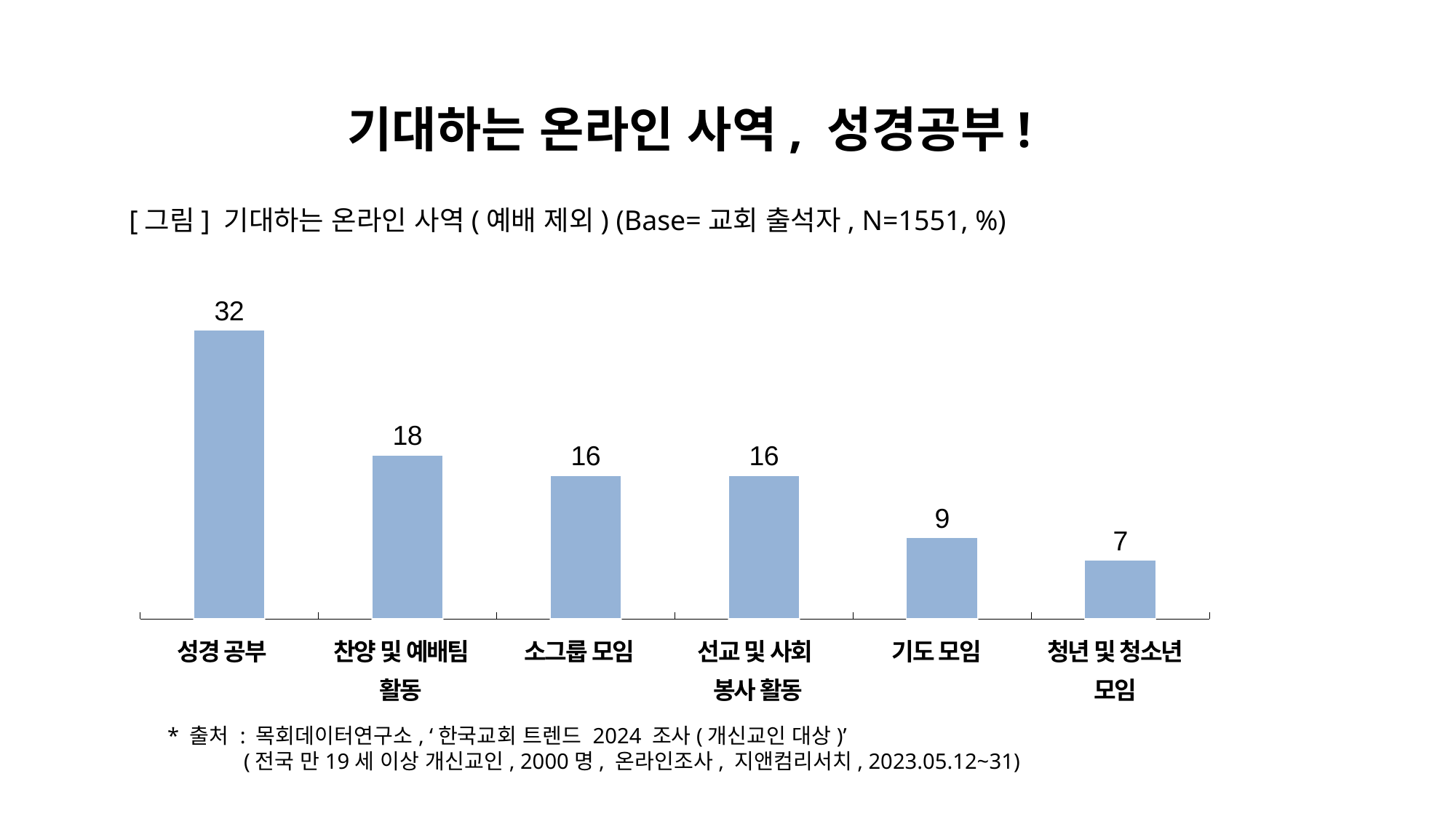
Which category has the lowest value? 청년 및 청소년 모임 Do the values rise or fall from left to right along the x axis? Fall What is the value for 찬양 및 예배팀 활동? 18 What is the difference between the values for 성경 공부 and 찬양 및 예배팀 활동? 14 Which category has the highest value? 성경 공부 What is the value for 기도 모임? 9 What is the value for 청년 및 청소년 모임? 7 What is the difference between the values for 기도 모임 and 청년 및 청소년 모임? 2 Which is larger, the value for 소그룹 모임 or the value for 기도 모임? 소그룹 모임 What kind of chart is shown on the slide? Bar chart How many categories are shown in the chart? 6 What is the value for 성경 공부? 32